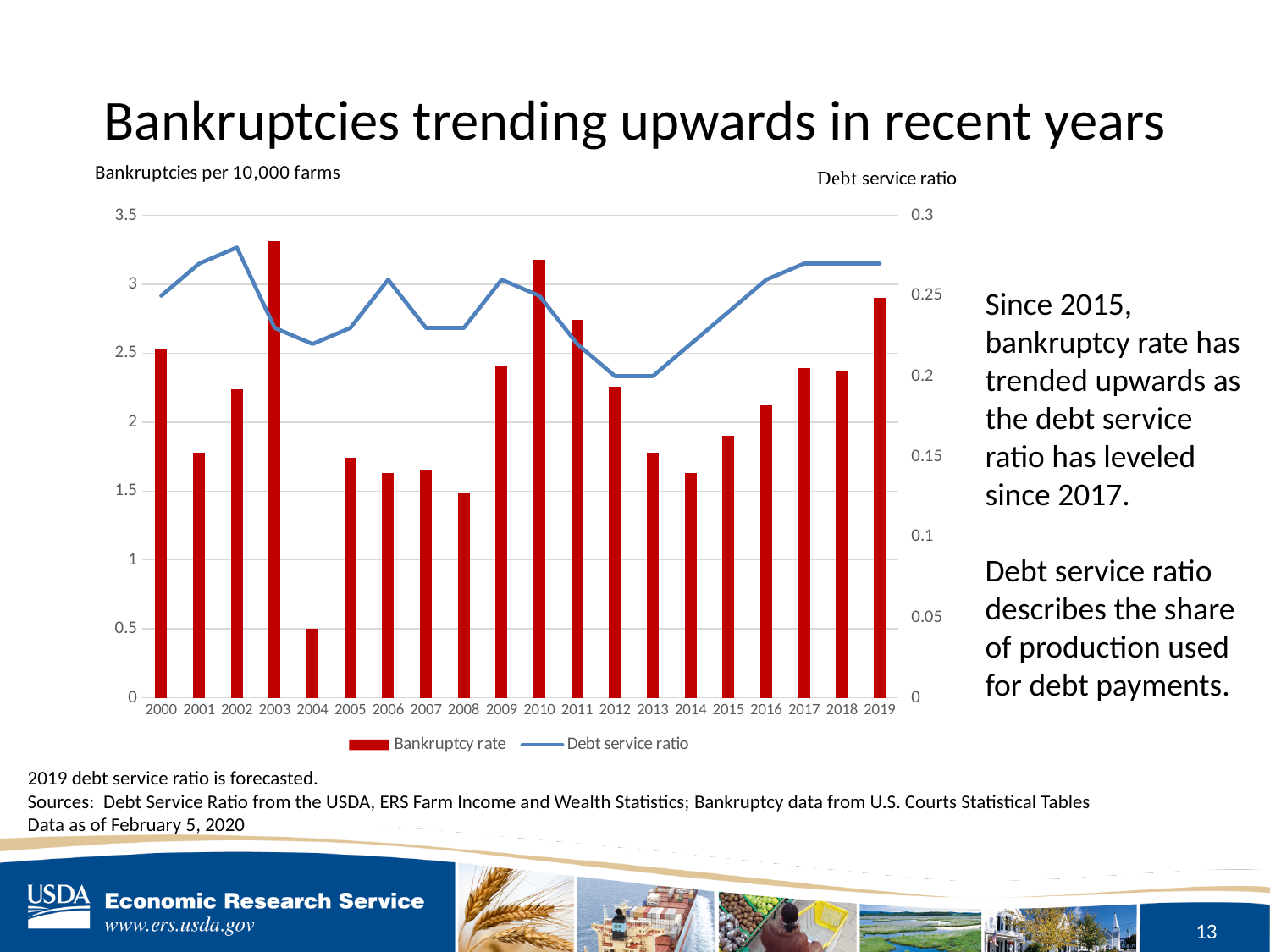
Does the bankruptcy rate rise or fall from 2015 to 2019? rise Is the bankruptcy rate for 2004 greater or less than 1? less Which year has the highest bankruptcy rate? 2003 What kind of chart is shown on the slide? A combination bar and line chart Is the debt service ratio for 2012 greater or less than 0.25? less Is the bankruptcy rate for 2003 greater or less than 3? greater Which year has the larger bankruptcy rate, 2010 or 2011? 2010 How many years are shown on the x axis of the chart? 20 How many series does the chart legend list? 2 What is the label on the left vertical axis of the chart? Bankruptcies per 10,000 farms Which year has the lowest bankruptcy rate? 2004